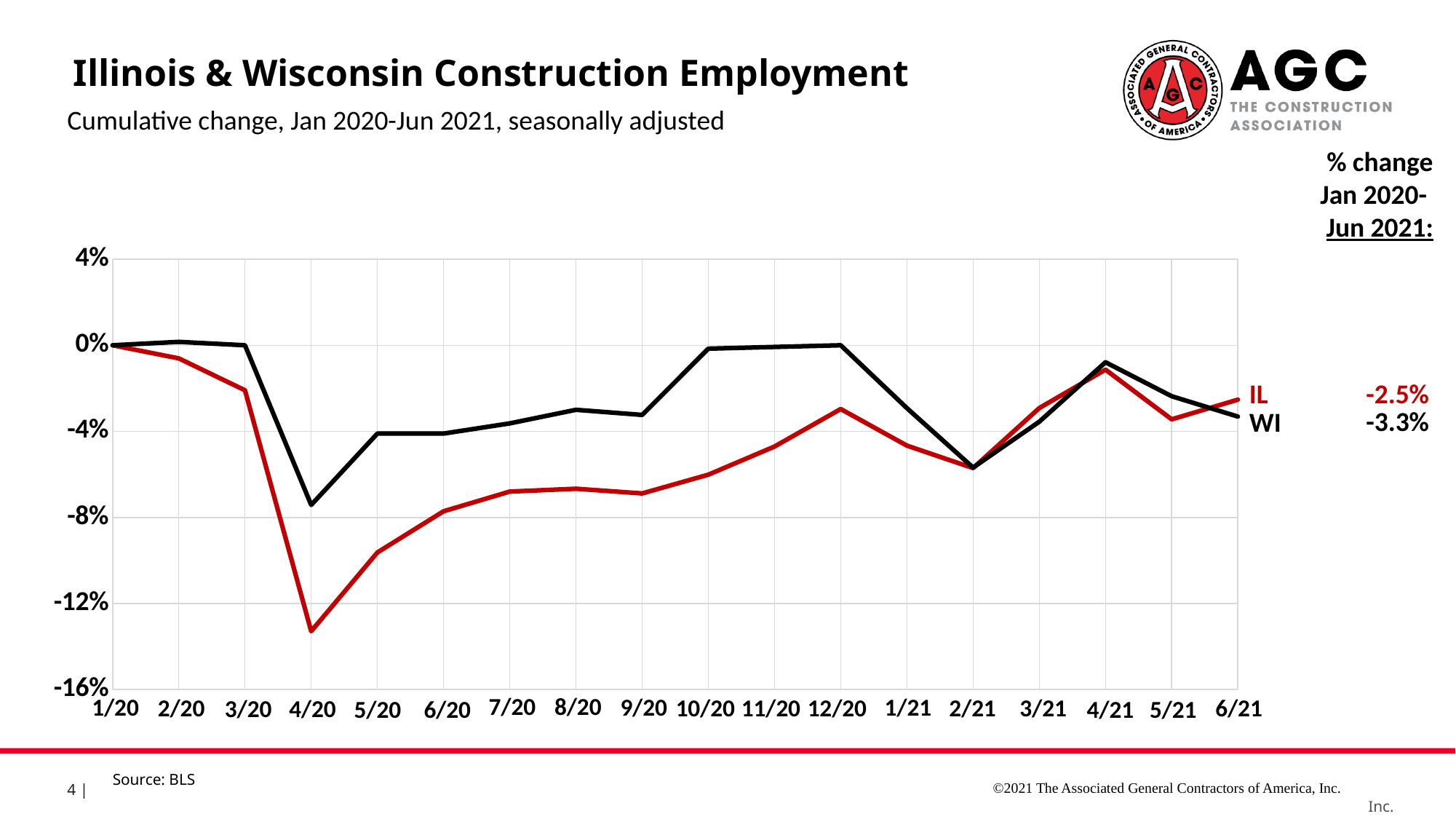
What is the difference in percentage points between the IL and WI cumulative changes at 6/21? 0.8 Is the value for WI at 4/20 greater or less than -8%? greater Is the value for WI at 10/20 greater or less than -4%? greater Is the value for IL at 4/20 greater or less than -12%? less What is the cumulative % change for IL from Jan 2020 to Jun 2021? -2.5% Which state has the higher cumulative change at 6/21, IL or WI? IL What type of chart is shown on the slide? line chart What is the cumulative % change for WI from Jan 2020 to Jun 2021? -3.3% How many series are plotted on the chart? 2 At which month does the IL line reach its lowest point? 4/20 How many months are shown along the x axis? 18 What is the source cited for the chart data? BLS